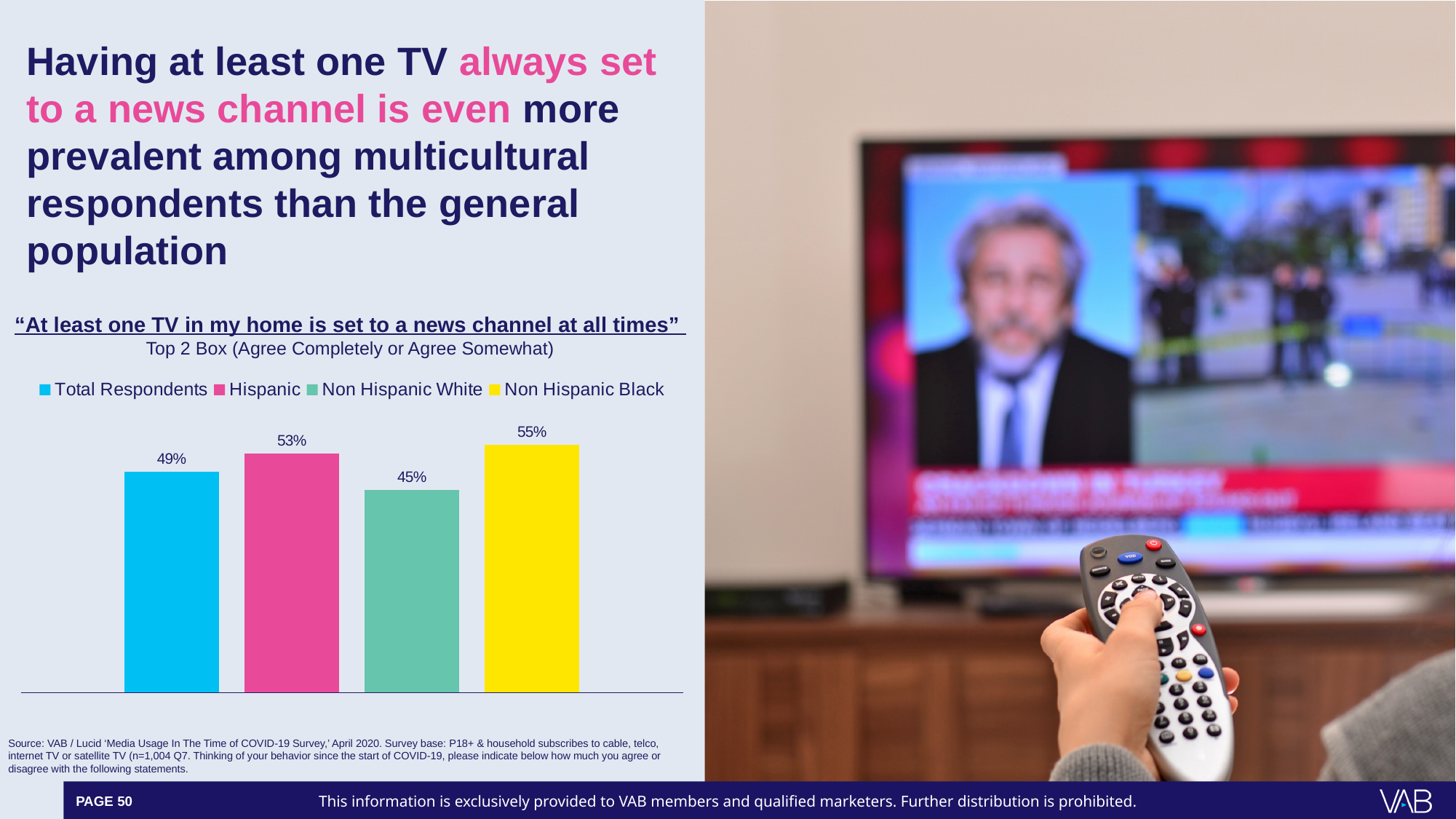
What is the value shown for Non Hispanic Black respondents? 55% Which group has the highest percentage agreeing with the statement? Non Hispanic Black What is the value shown for Hispanic respondents? 53% How many groups are plotted in the chart? 4 What is the difference in percentage points between Hispanic respondents and Total Respondents? 4 percentage points What is the value shown for Non Hispanic White respondents? 45% Which group has the lowest percentage agreeing with the statement? Non Hispanic White What percentage of Total Respondents agree that at least one TV in their home is set to a news channel at all times? 49% What type of chart is shown on the slide? Bar chart Which is larger, the value for Hispanic respondents or the value for Total Respondents? Hispanic What colour is the bar for Non Hispanic Black respondents? Yellow What is the difference in percentage points between Non Hispanic Black and Non Hispanic White respondents? 10 percentage points